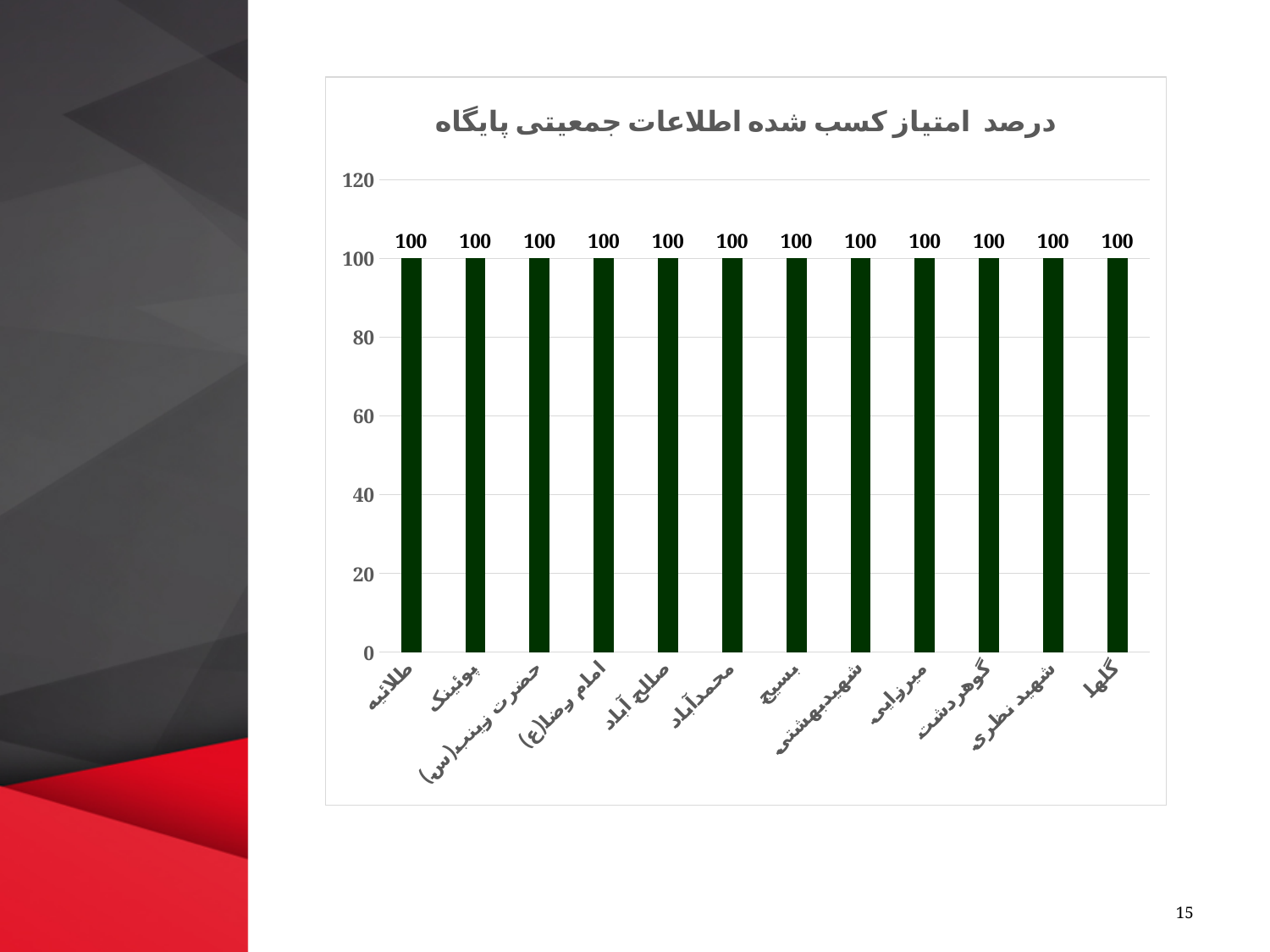
What is the value for بسیج? 100 What is the difference between the values for محمدآباد and میرزایی? 0 Do the values rise, fall, or stay the same across the categories along the x axis? stay the same What is the title of the chart? درصد امتیاز کسب شده اطلاعات جمعیتی پایگاه What is the value for گوهردشت? 100 What is the value for طلائیه? 100 How many categories are shown on the x axis? 12 What is the value for گلها? 100 What is the highest value shown on the y axis? 120 Is the value for شهید نظری greater or less than 120? less What kind of chart is shown on the slide? bar chart